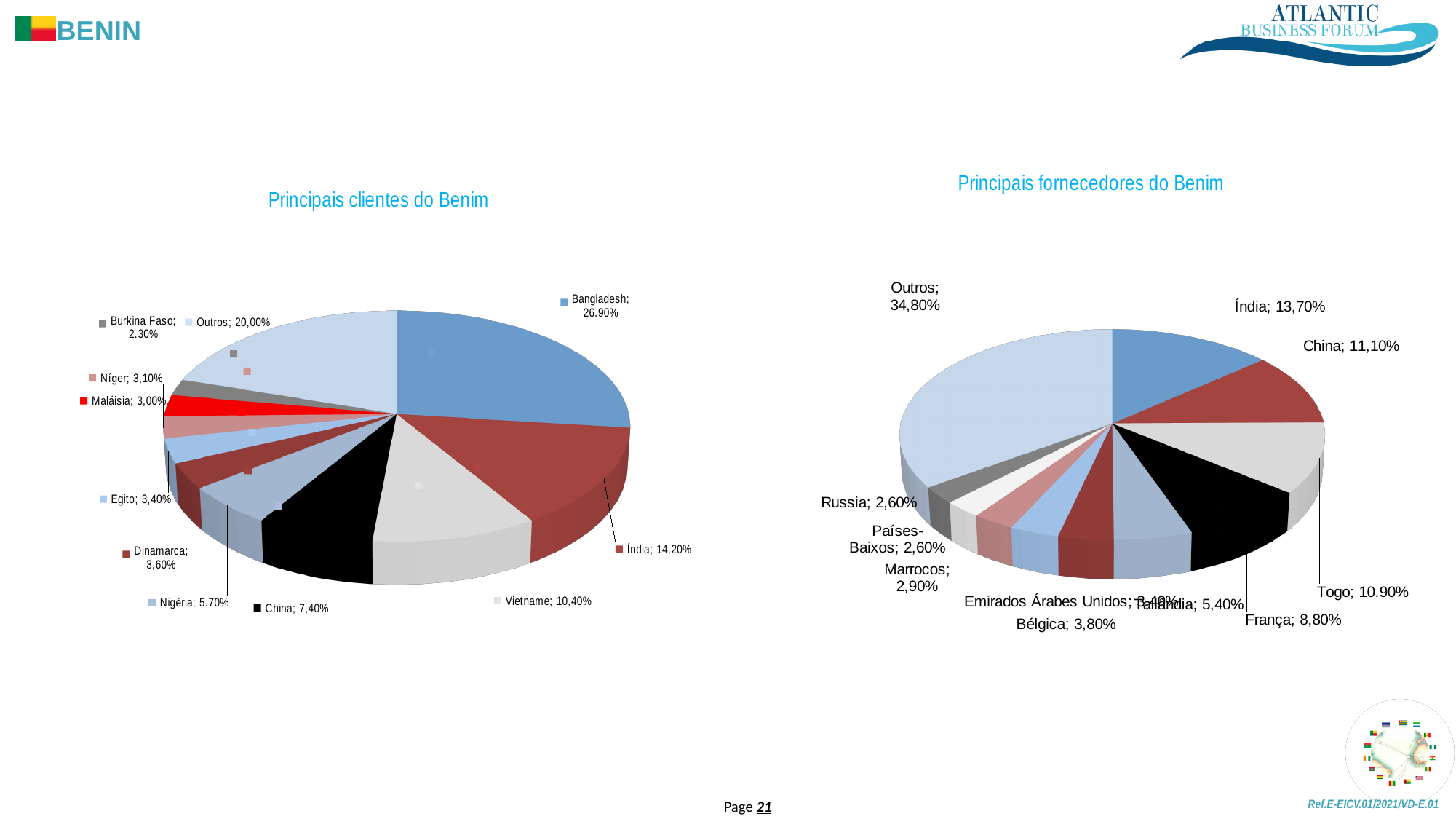
In the chart titled "Principais fornecedores do Benim", which is larger, the share of Índia or the share of China? Índia In the chart titled "Principais clientes do Benim", which named country (excluding Outros) has the largest share? Bangladesh In the chart titled "Principais fornecedores do Benim", what share does Togo have? 10.90% In the chart titled "Principais clientes do Benim", what share does Bangladesh have? 26.90% In the chart titled "Principais clientes do Benim", what is the difference between the shares of Índia and China? 6,80% In the chart titled "Principais fornecedores do Benim", what share does Outros have? 34,80% In the chart titled "Principais clientes do Benim", which category has the smallest share? Burkina Faso What is the title of the chart on the right side of the slide? Principais fornecedores do Benim What kind of chart is "Principais clientes do Benim"? Pie chart In the chart titled "Principais clientes do Benim", how many slices does the pie have? 11 In the chart titled "Principais fornecedores do Benim", what is the difference between the shares of França and Bélgica? 5,00% In the chart titled "Principais clientes do Benim", what share does Vietname have? 10,40%